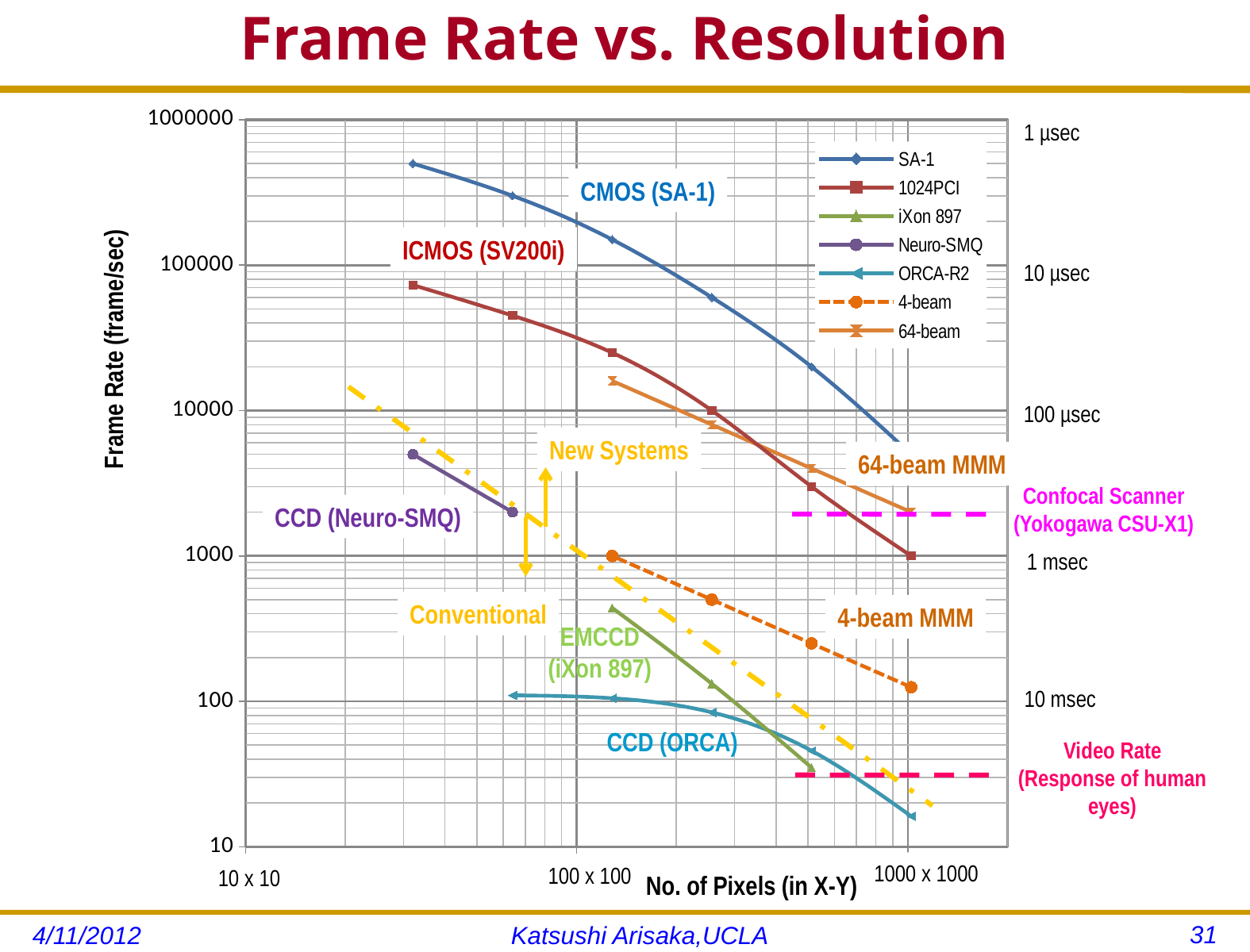
At 1000 x 1000 pixels, which has the higher frame rate, 64-beam or 4-beam? 64-beam Which series has the lowest frame rate at 1000 x 1000 pixels? ORCA-R2 What is the title of the chart? Frame Rate vs. Resolution Which series reaches the highest frame rate on the chart? SA-1 Does the frame rate for SA-1 rise or fall as the number of pixels increases? fall Is the value for ORCA-R2 at 1000 x 1000 pixels greater or less than 100? less At 100 x 100 pixels, which has the higher frame rate, SA-1 or 1024PCI? SA-1 What is the label of the y axis? Frame Rate (frame/sec) Is the value for SA-1 at 1000 x 1000 pixels greater or less than 1000? greater Is the value for iXon 897 at 100 x 100 pixels greater or less than 100? greater What kind of chart is shown on the slide? line chart How many series does the legend list? 7